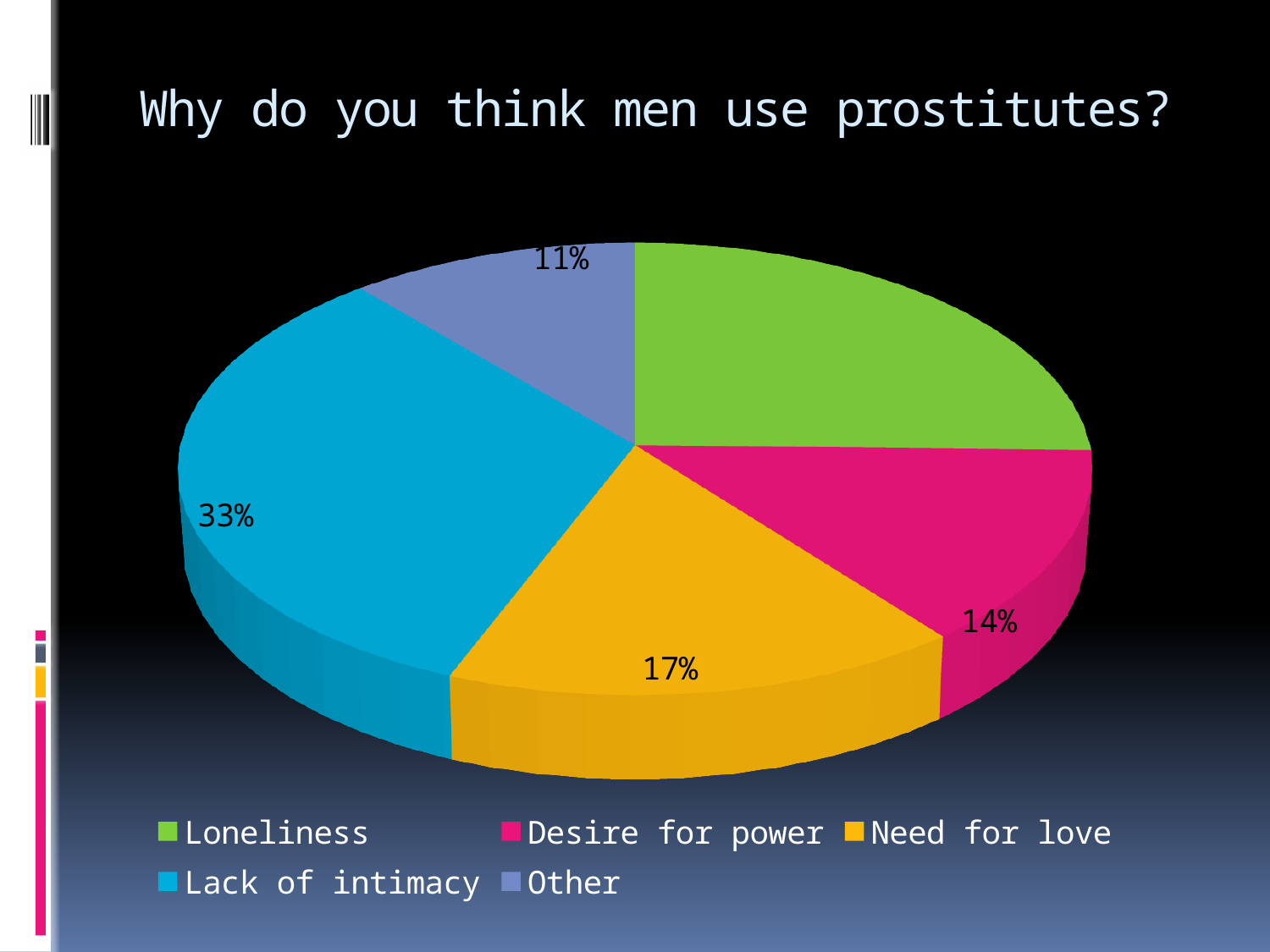
Which is larger, the slice for Need for love or the slice for Desire for power? Need for love What share of the pie does Need for love take? 17% What is the difference between the Need for love share and the Desire for power share? 3% What kind of chart is shown on the slide? pie chart What is the difference between the Lack of intimacy share and the Other share? 22% What share of the pie does Desire for power take? 14% Which category has the largest slice of the pie? Lack of intimacy How many categories are shown in the pie chart? 5 What share of the pie does Lack of intimacy take? 33% Which category has the smallest slice of the pie? Other What is the title of the chart? Why do you think men use prostitutes?